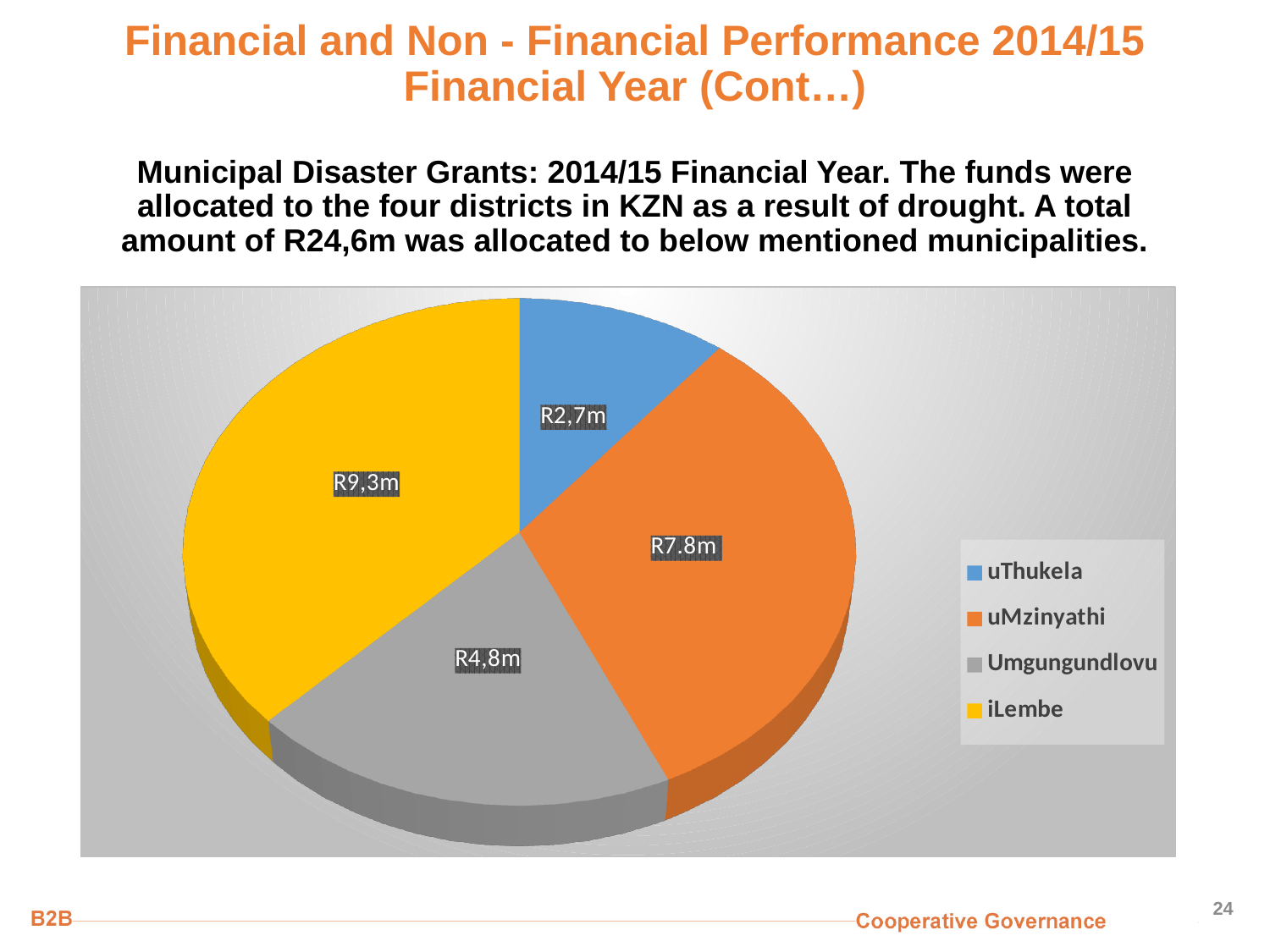
What amount was allocated to Umgungundlovu? R4,8m What amount was allocated to uThukela? R2,7m How much more was allocated to iLembe than to uThukela? R6,6m What amount was allocated to uMzinyathi? R7.8m Which received more funding, uMzinyathi or Umgungundlovu? uMzinyathi Which municipality received the largest allocation? iLembe How many municipalities (slices) are shown in the pie chart? 4 Which municipality received the smallest allocation? uThukela Which colour represents Umgungundlovu in the pie chart? grey What is the total amount allocated across the four municipalities? R24,6m What amount was allocated to iLembe? R9,3m What type of chart is shown on the slide? pie chart